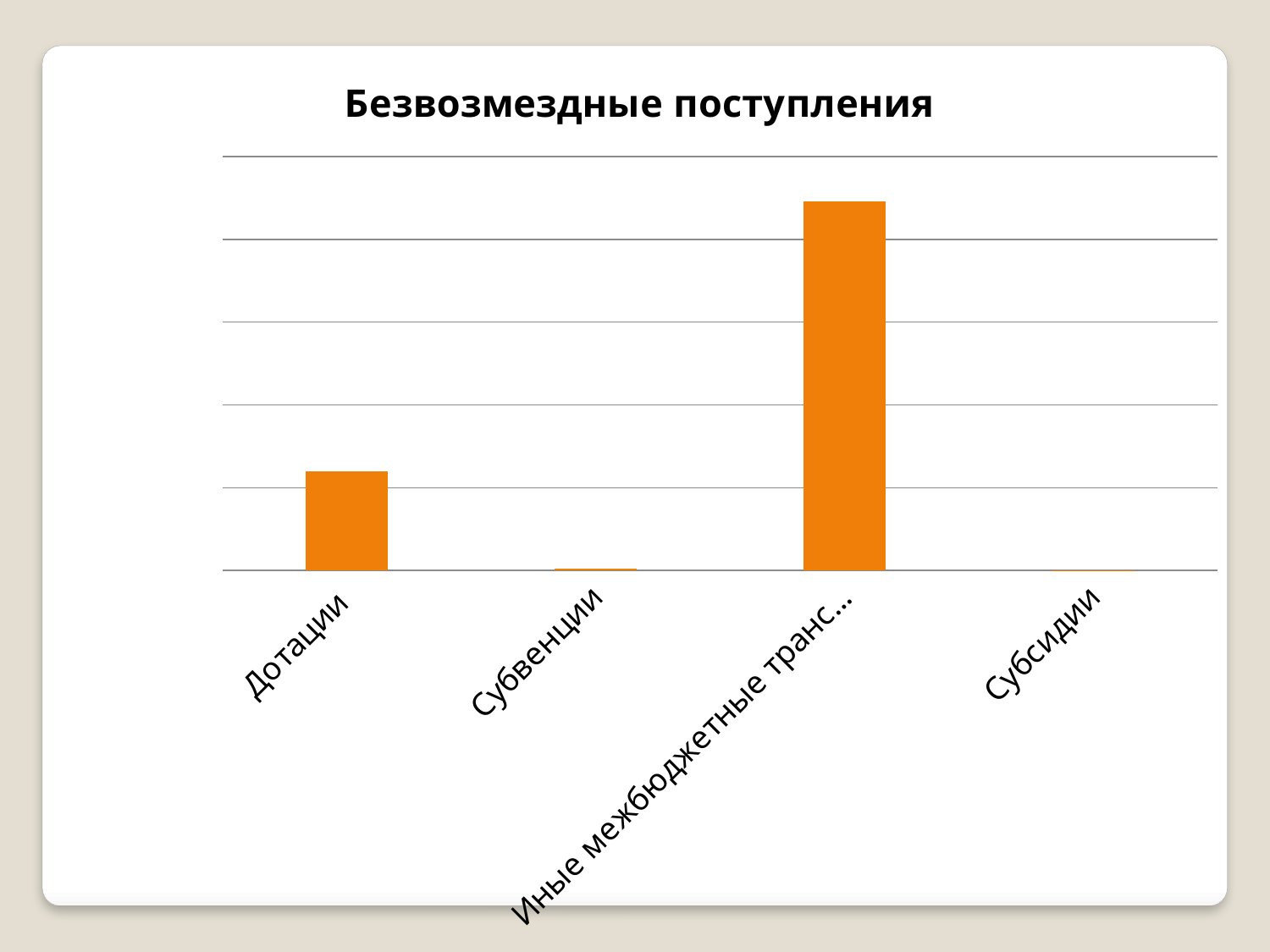
What is the title of the chart? Безвозмездные поступления Which is larger, the value for Дотации or the value for Субвенции? Дотации How many categories are shown on the x axis of the chart? 4 Which is larger, the value for Дотации or the value for Субсидии? Дотации Which category is listed first on the x axis of the chart? Дотации What colour are the bars in the chart? orange Which category has the highest bar in the chart? Иные межбюджетные транс… Which is larger, the value for Дотации or the value for Иные межбюджетные транс…? Иные межбюджетные транс… What kind of chart is shown on the slide? bar chart